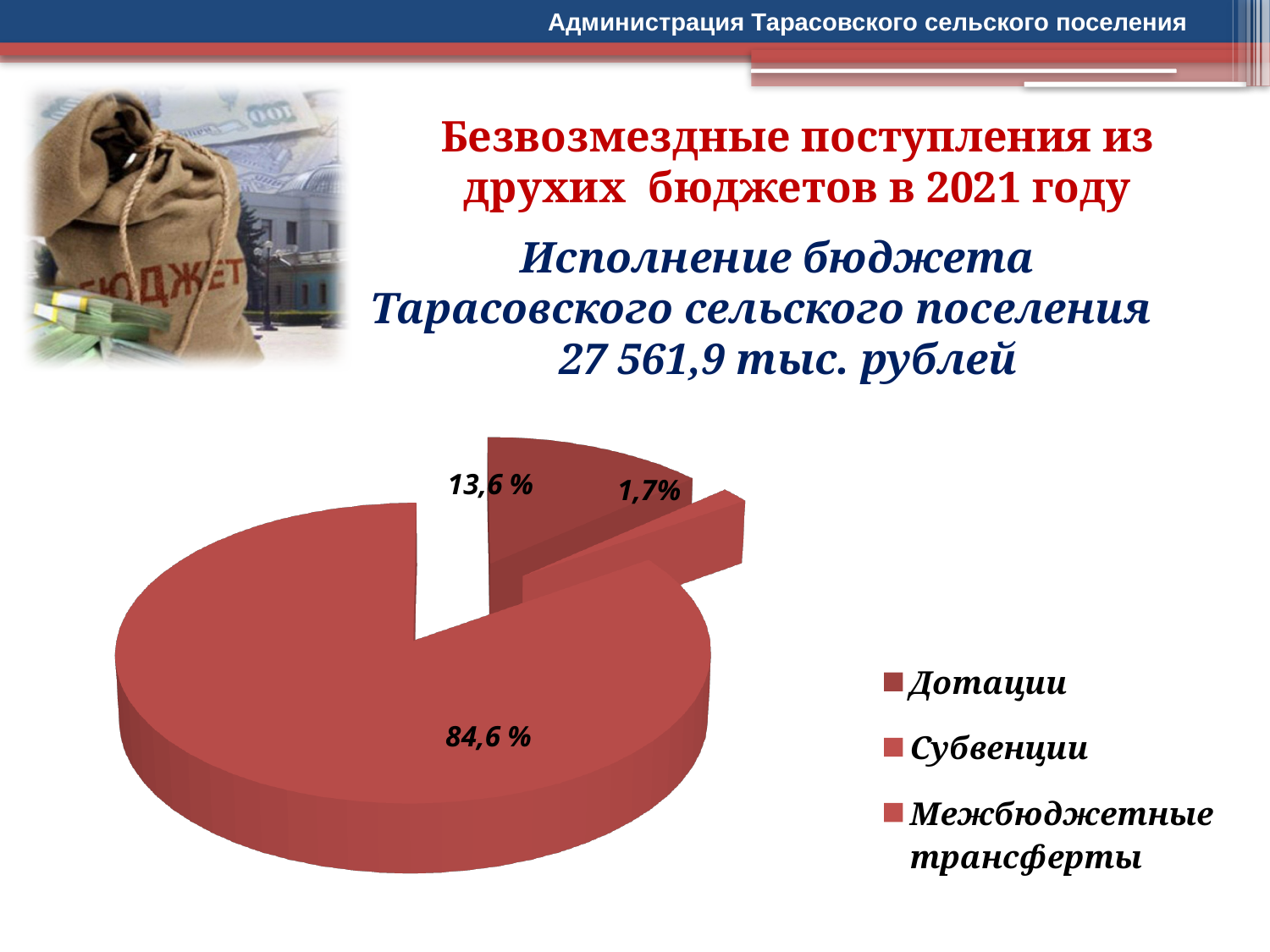
What total amount of budget execution is stated in the slide heading above the chart? 27 561,9 тыс. рублей Which is larger: the slice labelled 13,6 % or the slice labelled 1,7%? 13,6 % What kind of chart is shown on the slide? Pie chart How many slices does the pie chart have? 3 Is the largest slice of the pie chart greater or less than 50%? greater What is the percentage shown on the largest slice of the pie chart? 84,6 % What are the three legend entries of the pie chart? Дотации, Субвенции, Межбюджетные трансферты What is the percentage shown on the smallest slice of the pie chart? 1,7% How many entries does the legend of the pie chart list? 3 What is the difference in percentage points between the largest slice (84,6 %) and the second-largest slice (13,6 %)? 71,0 % What is the percentage shown on the middle-sized slice of the pie chart? 13,6 %